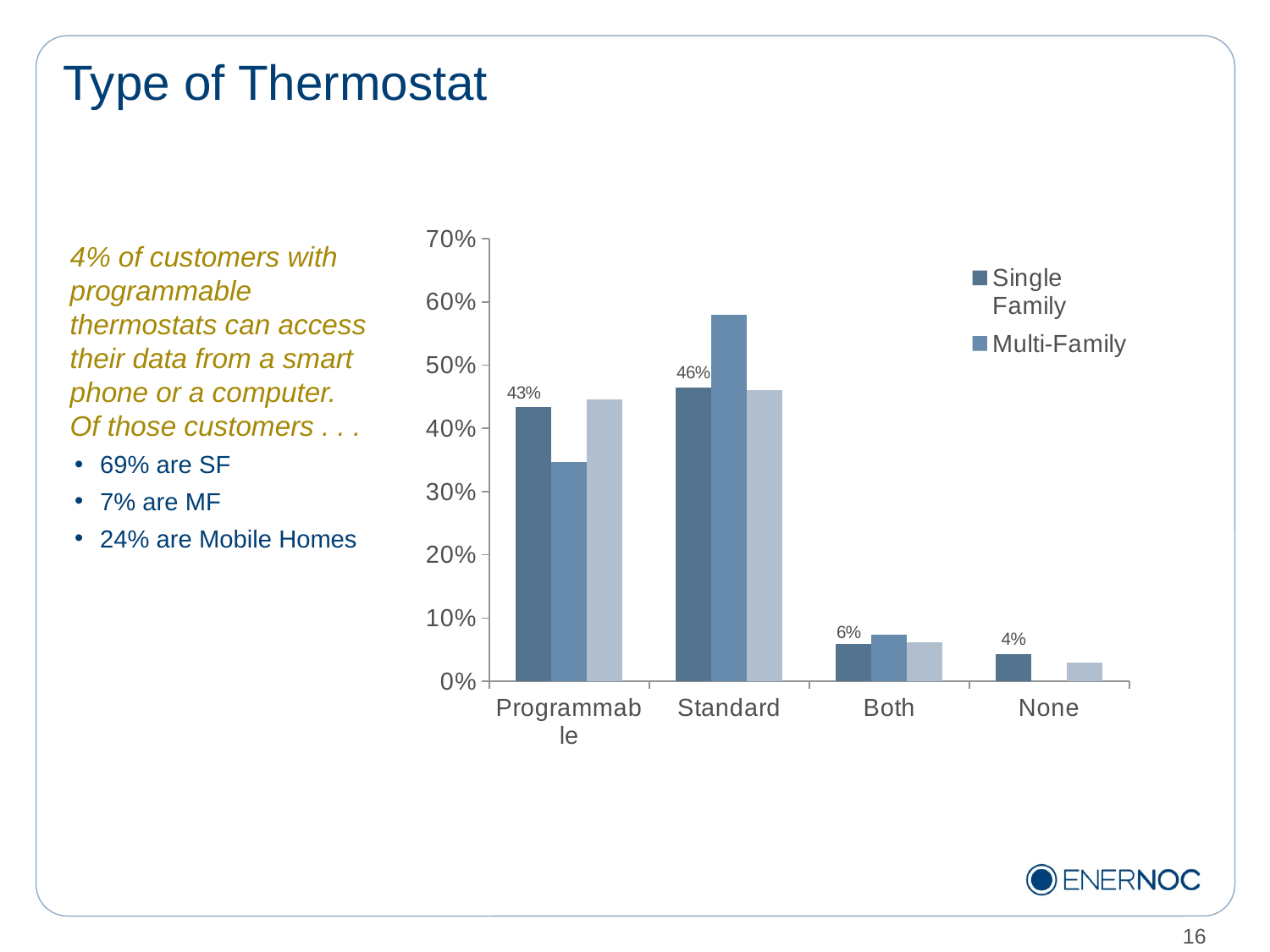
Which category has the lowest Single Family value? None What is the Single Family value for the Both category? 6% How many thermostat categories are shown on the x axis? 4 What is the difference between the Single Family values for Standard and Programmable? 3 percentage points Which category has the highest Single Family value? Standard How many series does the legend list? 2 What is the Single Family value for Programmable thermostats? 43% Is the Multi-Family value for Standard greater or less than 50%? greater Is the Multi-Family value for Programmable greater or less than 40%? less What is the Single Family value for the None category? 4% What is the Single Family value for Standard thermostats? 46% What kind of chart is shown on the slide? Bar chart